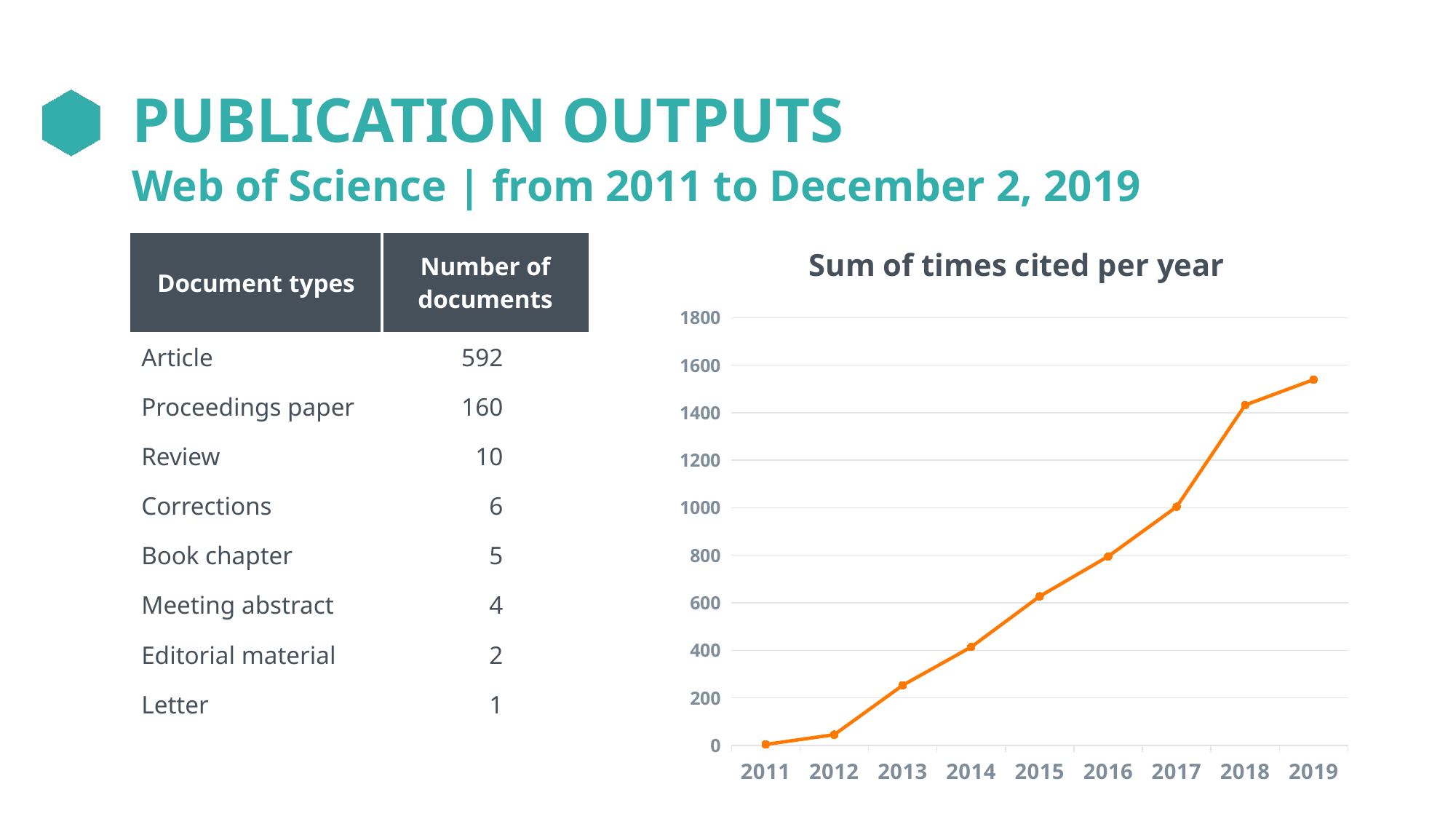
How many years are plotted on the x axis of the chart? 9 Which year has the highest sum of times cited? 2019 Which year has the larger sum of times cited, 2017 or 2018? 2018 Is the value for 2013 greater or less than 400? less Is the value for 2018 greater or less than 1200? greater What is the title of the chart on the slide? Sum of times cited per year Which year has the lowest sum of times cited? 2011 Is the value for 2019 greater or less than 1600? less Do the values in the chart rise or fall from 2011 to 2019? rise What kind of chart is shown on the slide? line chart